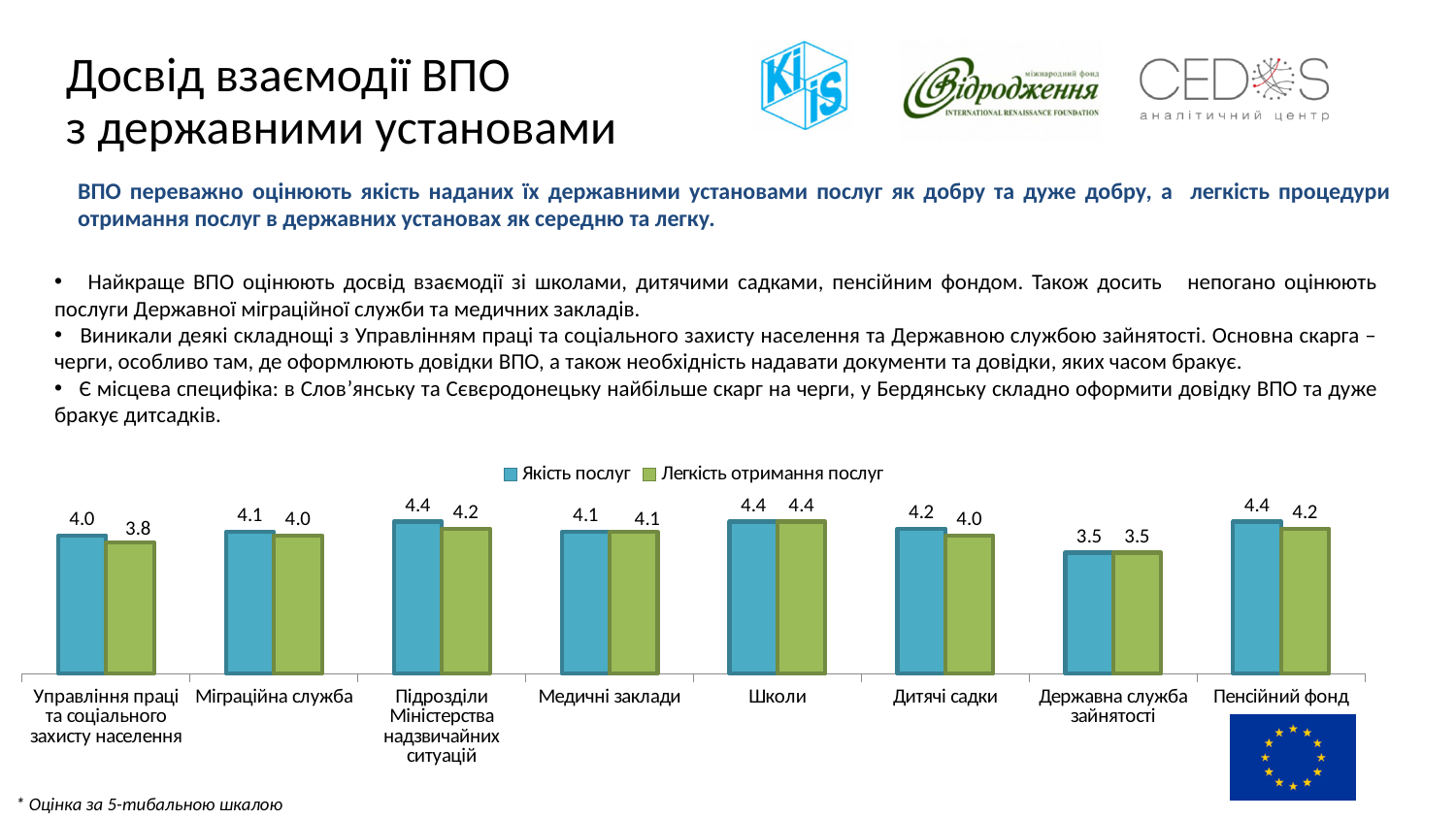
What type of chart is shown on the slide? bar chart Which is larger for "Підрозділи Міністерства надзвичайних ситуацій": "Якість послуг" or "Легкість отримання послуг"? Якість послуг What is the difference between "Якість послуг" and "Легкість отримання послуг" for "Пенсійний фонд"? 0.2 What is the value of "Якість послуг" for "Дитячі садки"? 4.2 Which category has the lowest value for "Якість послуг"? Державна служба зайнятості How many categories (institutions) are shown on the x axis of the chart? 8 What is the value of "Легкість отримання послуг" for "Управління праці та соціального захисту населення"? 3.8 What is the value of "Якість послуг" for "Міграційна служба"? 4.1 What is the difference in "Якість послуг" between "Школи" and "Державна служба зайнятості"? 0.9 Which series in the legend is shown in green? Легкість отримання послуг How many series does the chart legend list? 2 Which category has the highest value for "Легкість отримання послуг"? Школи